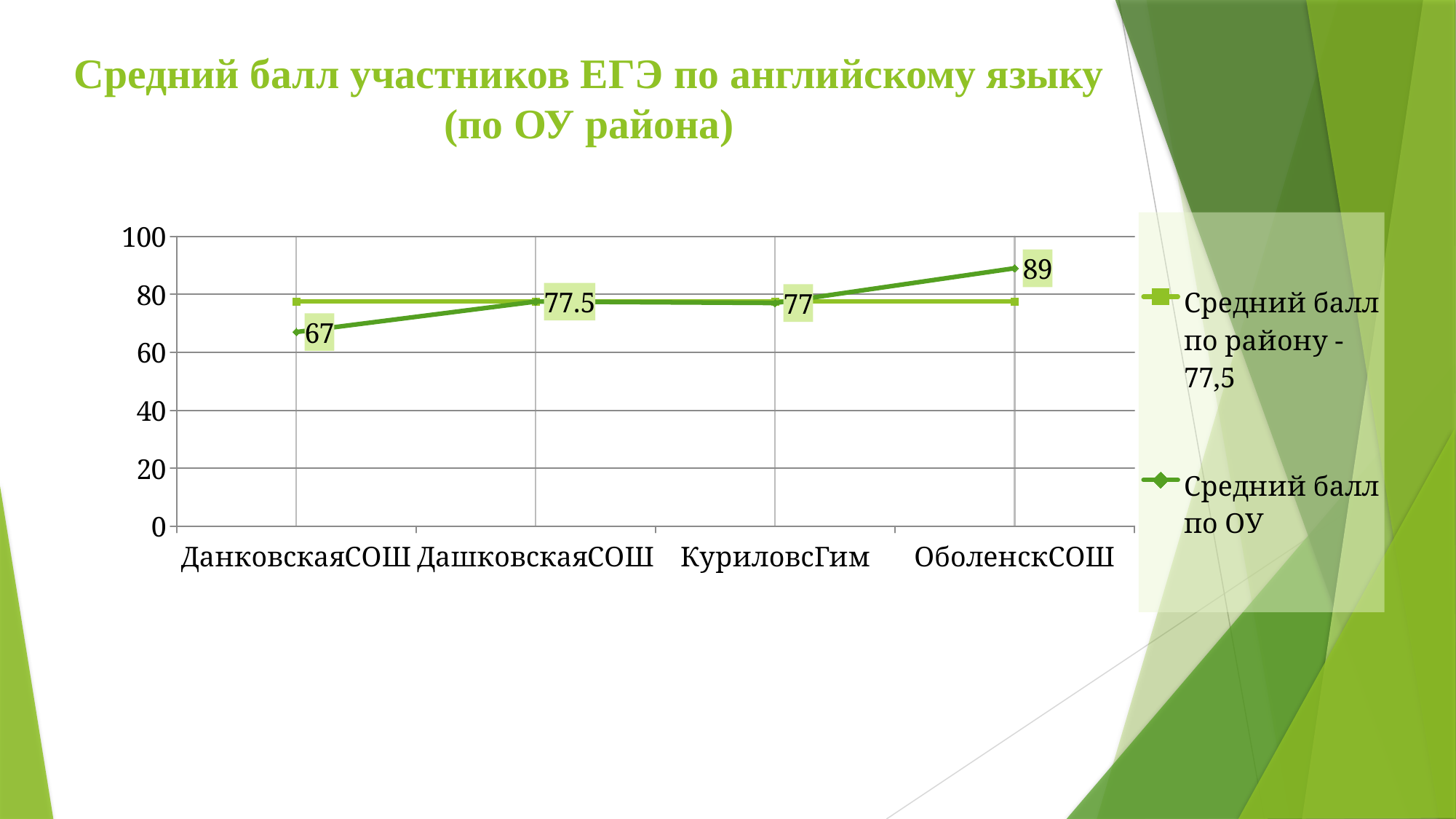
What kind of chart is shown on the slide? Line chart Which school has a higher average score, ДанковскаяСОШ or КуриловсГим? КуриловсГим What is the difference between the average scores of ОболенскСОШ and ДанковскаяСОШ? 22 What is the average score (Средний балл по ОУ) for ОболенскСОШ? 89 What is the average score (Средний балл по ОУ) for ДанковскаяСОШ? 67 How many series does the legend list? 2 What is the average score (Средний балл по ОУ) for ДашковскаяСОШ? 77.5 Which school has the lowest average score in the Средний балл по ОУ series? ДанковскаяСОШ What is the average score (Средний балл по ОУ) for КуриловсГим? 77 According to the legend, what is the district average score (Средний балл по району)? 77,5 How many schools are shown on the x axis of the chart? 4 Which school has the highest average score in the Средний балл по ОУ series? ОболенскСОШ